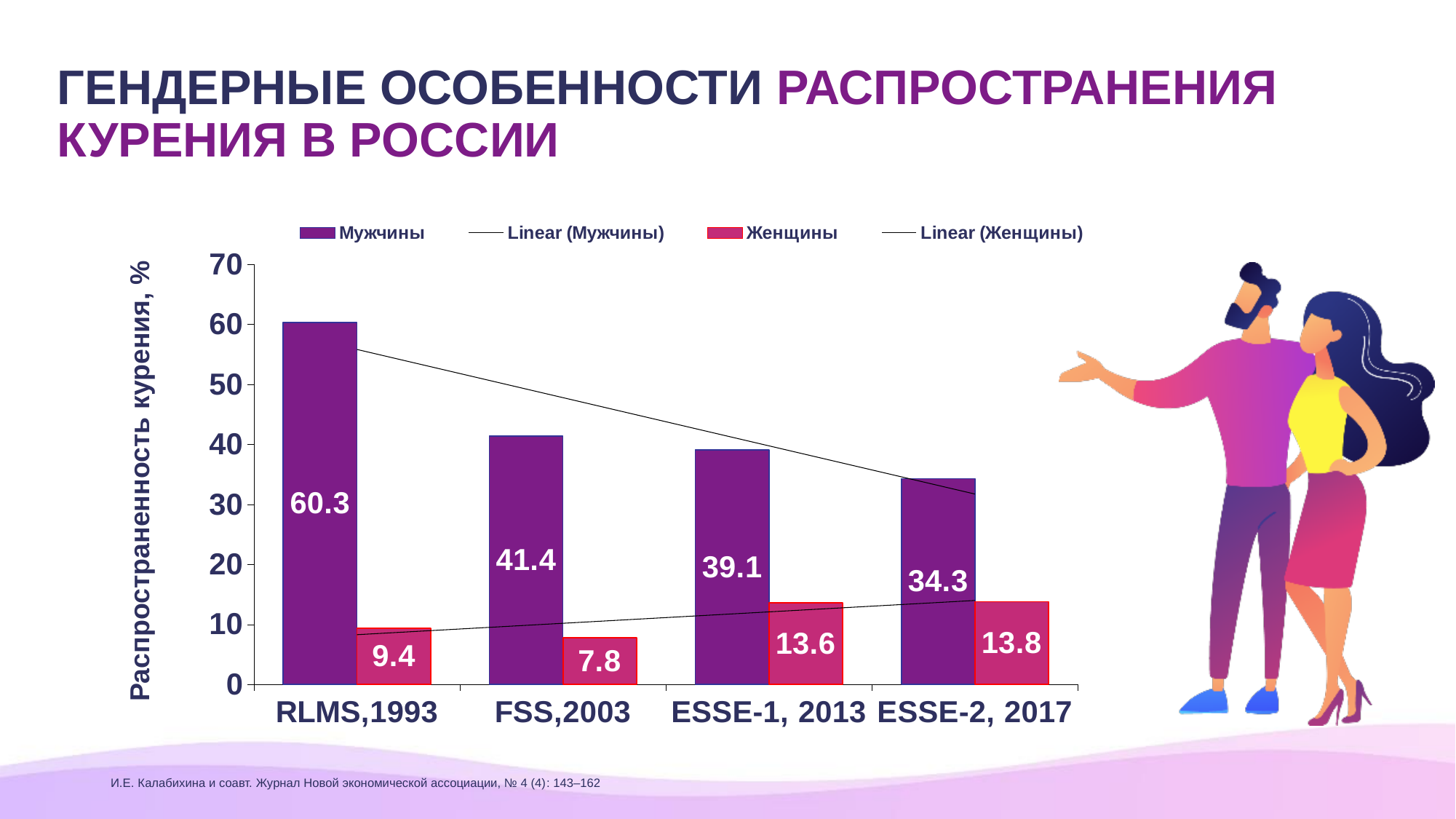
Which is larger: the Мужчины value in FSS,2003 or the Мужчины value in ESSE-1, 2013? FSS,2003 What is the difference between the Мужчины and Женщины values in ESSE-2, 2017? 20.5 What is the value for Мужчины in RLMS,1993? 60.3 How many categories are shown on the x axis? 4 How many entries does the legend list? 4 What kind of chart is shown on the slide? bar chart Is the value for Мужчины in RLMS,1993 greater or less than 50? greater What is the value for Женщины in ESSE-1, 2013? 13.6 In which category is the value for Женщины the lowest? FSS,2003 What is the value for Женщины in FSS,2003? 7.8 Do the Мужчины values rise or fall from RLMS,1993 to ESSE-2, 2017? fall In which category is the value for Мужчины the lowest? ESSE-2, 2017